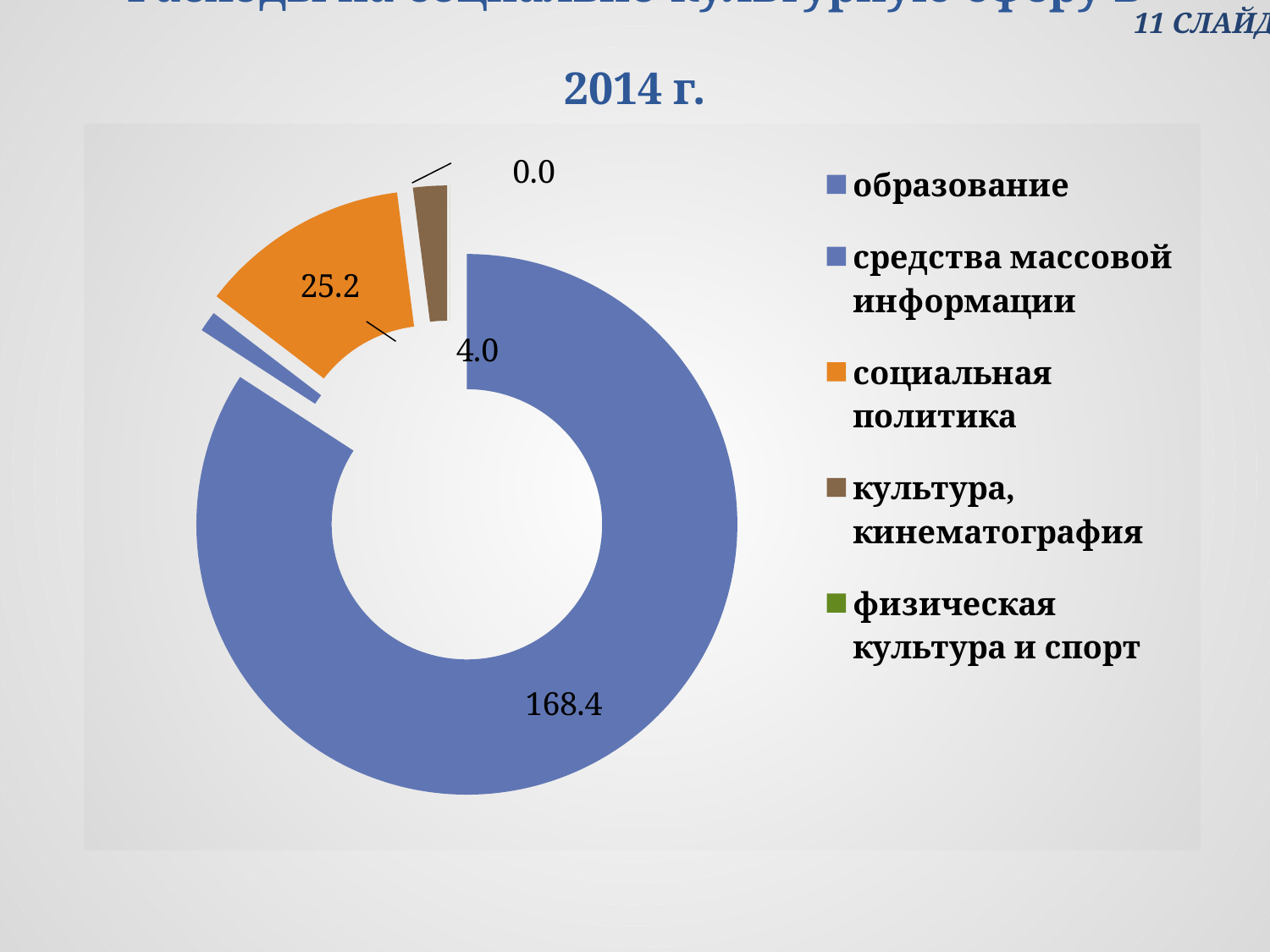
What is the value shown for культура, кинематография? 4.0 What is the difference between the values for образование and социальная политика? 143.2 Which category has the largest value in the chart? образование Which is larger, the value for социальная политика or the value for культура, кинематография? социальная политика Which category has the smallest value in the chart? физическая культура и спорт What colour represents социальная политика in the chart? orange What is the value shown for образование? 168.4 What is the value shown for социальная политика? 25.2 What kind of chart is shown on the slide? doughnut chart What is the value shown for физическая культура и спорт? 0.0 How many categories does the legend list? 5 What is the difference between the values for социальная политика and культура, кинематография? 21.2